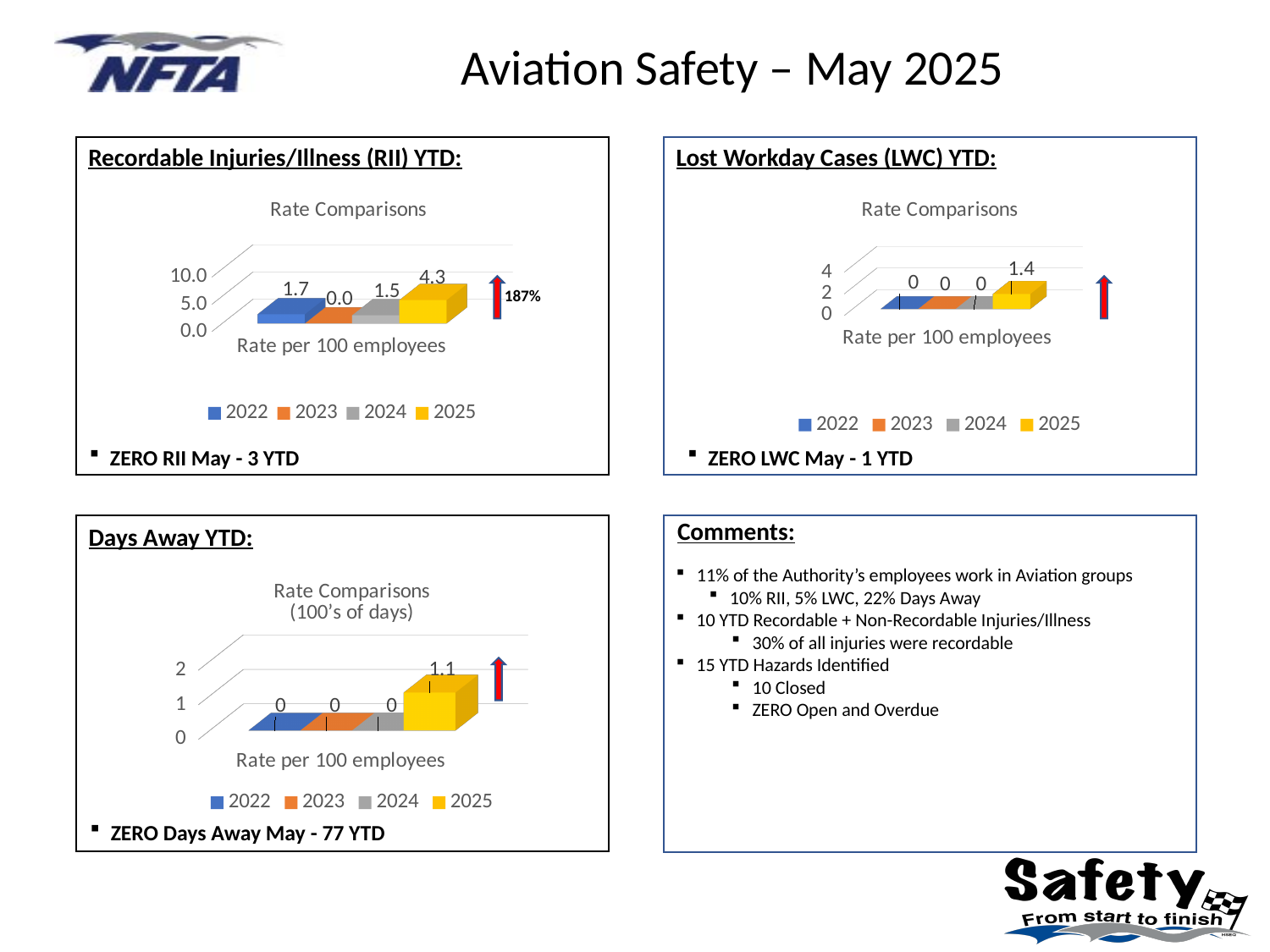
In the Recordable Injuries/Illness (RII) YTD chart, what is the rate per 100 employees for 2022? 1.7 In the Days Away YTD chart, how many series does the legend list? 4 What kind of chart is the Days Away YTD chart? Bar chart In the Lost Workday Cases (LWC) YTD chart, what is the rate per 100 employees for 2023? 0 In the Lost Workday Cases (LWC) YTD chart, what is the rate per 100 employees for 2025? 1.4 In the Recordable Injuries/Illness (RII) YTD chart, which is larger, the 2022 rate or the 2024 rate? 2022 In the Recordable Injuries/Illness (RII) YTD chart, which year has the highest rate? 2025 In the Recordable Injuries/Illness (RII) YTD chart, what is the difference between the 2025 rate and the 2024 rate? 2.8 In the Recordable Injuries/Illness (RII) YTD chart, which year has the lowest rate? 2023 In the Days Away YTD chart, what is the rate per 100 employees for 2025? 1.1 In the Lost Workday Cases (LWC) YTD chart, which colour represents 2025 in the legend? Yellow In the Recordable Injuries/Illness (RII) YTD chart, what is the rate per 100 employees for 2025? 4.3